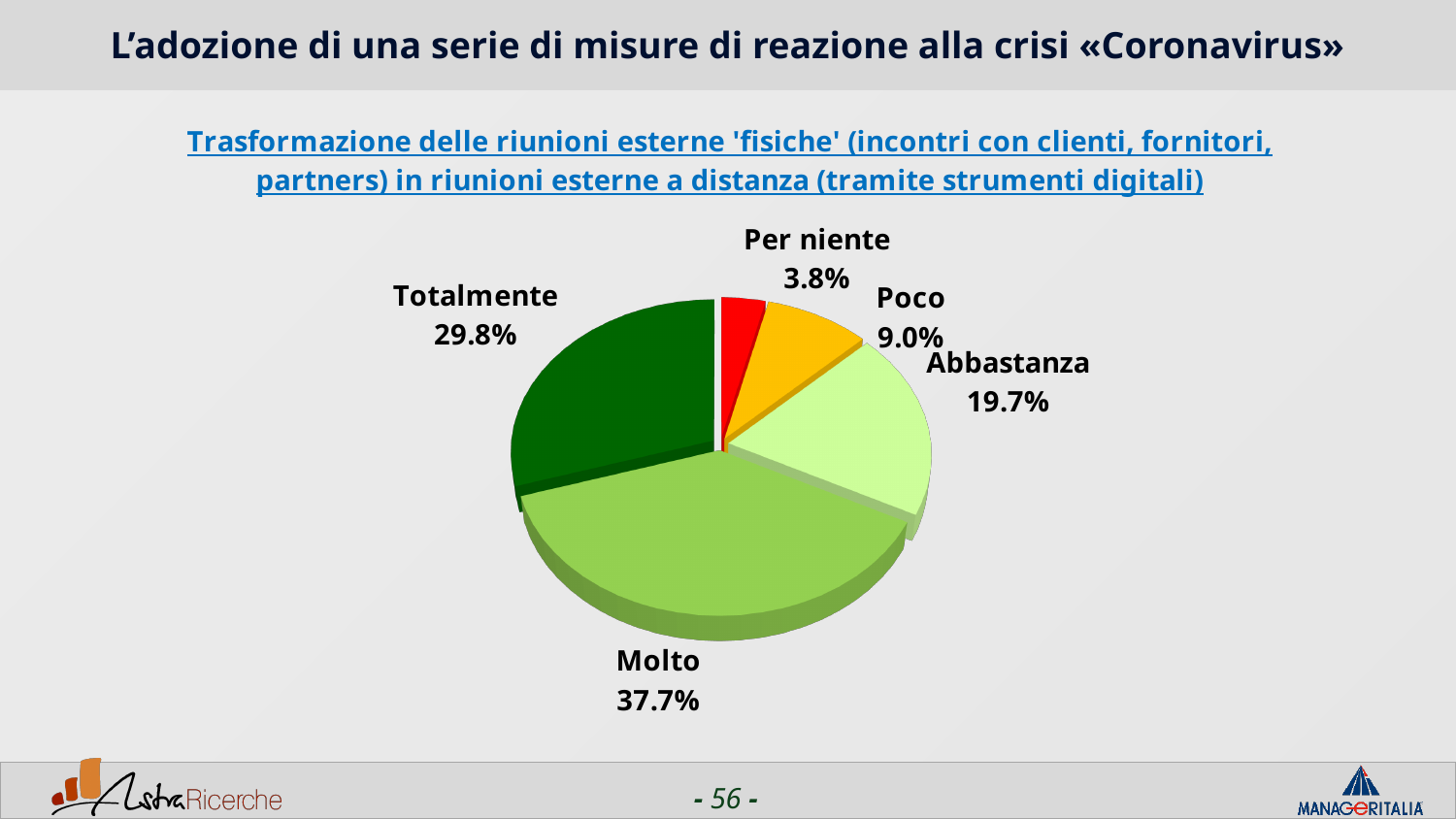
What is the difference in percentage points between 'Molto' and 'Totalmente'? 7.9 What percentage is shown for 'Per niente'? 3.8% Which category has the largest slice of the pie? Molto What percentage is shown for 'Poco'? 9.0% What colour is the 'Per niente' slice? red What percentage is shown for 'Molto'? 37.7% Which is larger, the share for 'Abbastanza' or the share for 'Poco'? Abbastanza What kind of chart is shown on the slide? pie chart How many slices does the pie chart have? 5 Which category has the smallest slice of the pie? Per niente What percentage is shown for 'Abbastanza'? 19.7% What percentage is shown for 'Totalmente'? 29.8%